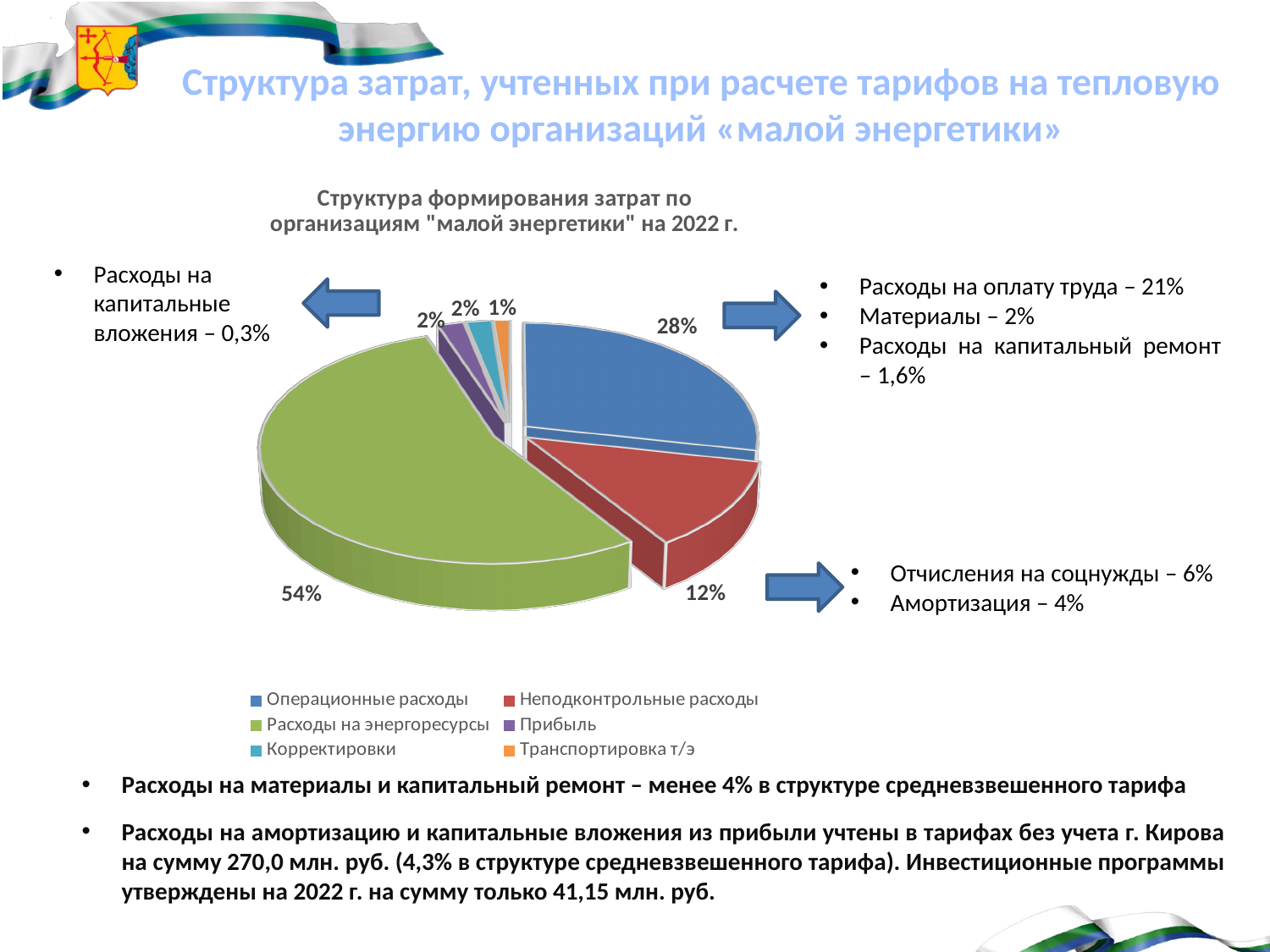
How many categories does the legend list? 6 What is the title of the chart? Структура формирования затрат по организациям "малой энергетики" на 2022 г. What share of the pie does Неподконтрольные расходы take? 12% Which category has the smallest slice of the pie? Транспортировка т/э What is the difference in percentage points between Расходы на энергоресурсы and Операционные расходы? 26 What share of the pie does Транспортировка т/э take? 1% What share of the pie does Операционные расходы take? 28% Which category has the largest slice of the pie? Расходы на энергоресурсы What share of the pie does Расходы на энергоресурсы take? 54% What share of the pie does Прибыль take? 2% Which is larger: Операционные расходы or Неподконтрольные расходы? Операционные расходы What kind of chart is shown on the slide? Pie chart